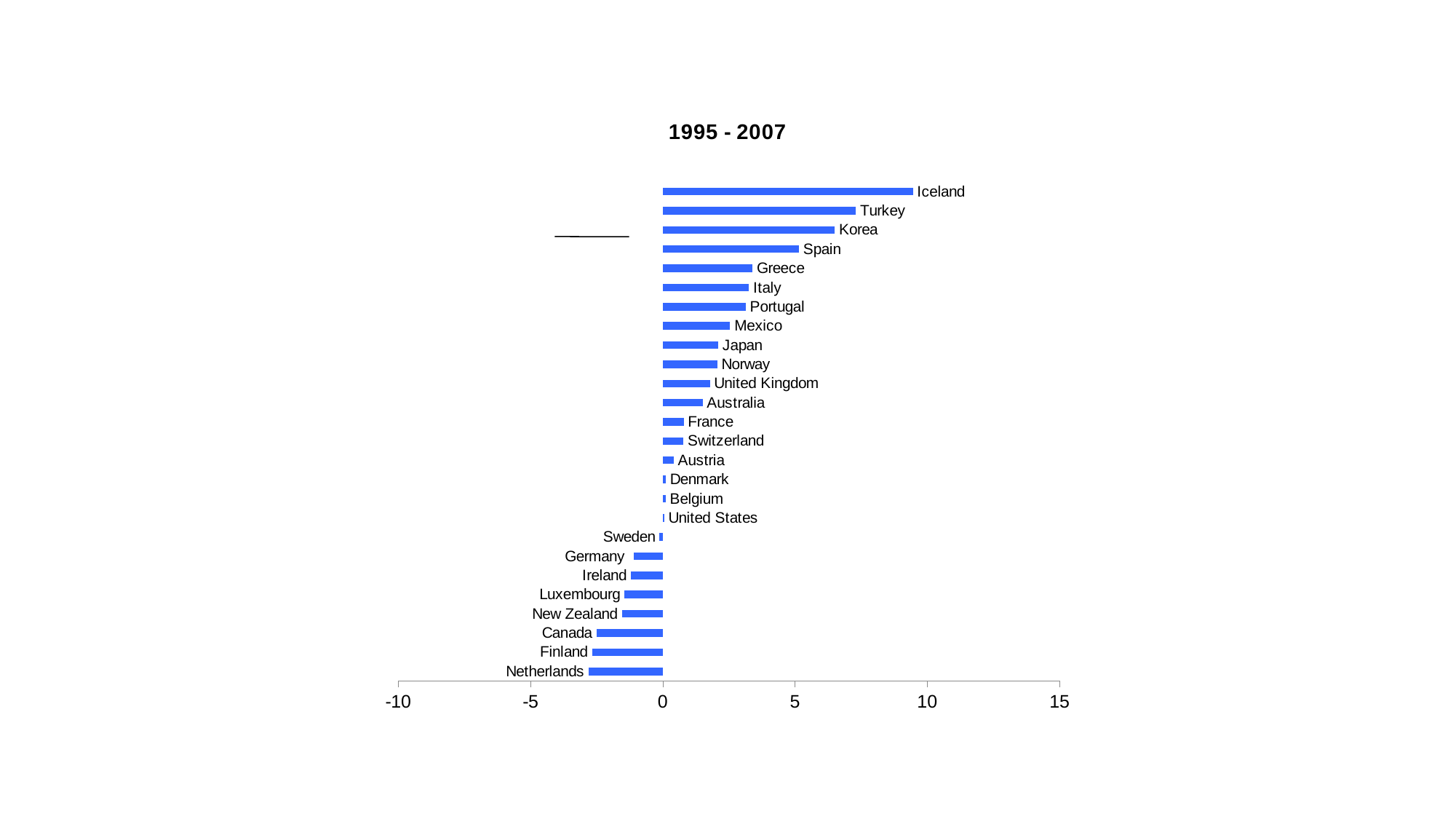
Which country has the lowest value in the chart? Netherlands What kind of chart is shown on the slide? bar chart How many countries are shown in the chart? 26 What is the title of the chart? 1995 - 2007 Which has the larger value, Korea or Greece? Korea Is the value for Netherlands greater or less than -5? greater Is the value for Greece greater or less than 5? less Which has the larger value, Iceland or Turkey? Iceland Is the value for Canada greater or less than 0? less Which country has the highest value in the chart? Iceland